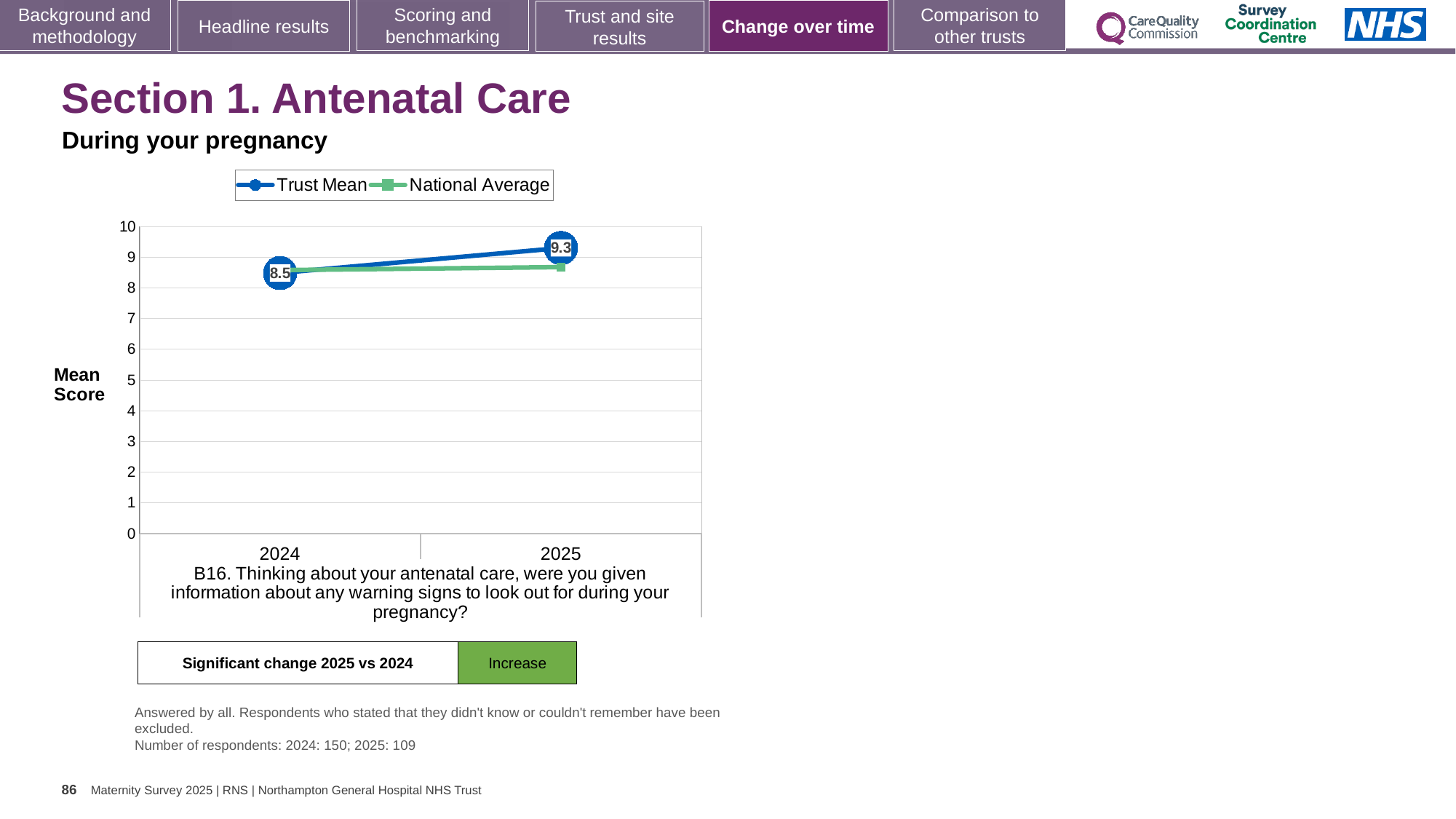
Which year has the higher Trust Mean, 2024 or 2025? 2025 Does the Trust Mean rise or fall from 2024 to 2025? rise What is the Trust Mean value for 2025? 9.3 Is the National Average value for 2025 greater or less than 8? greater What is the Trust Mean value for 2024? 8.5 Is the National Average value for 2024 greater or less than 5? greater In 2025, which series has the higher value, Trust Mean or National Average? Trust Mean What kind of chart is shown on the slide? line chart How many years are shown on the x axis of the chart? 2 What is the difference between the Trust Mean in 2025 and in 2024? 0.8 How many series does the legend list? 2 What is the label on the y axis of the chart? Mean Score